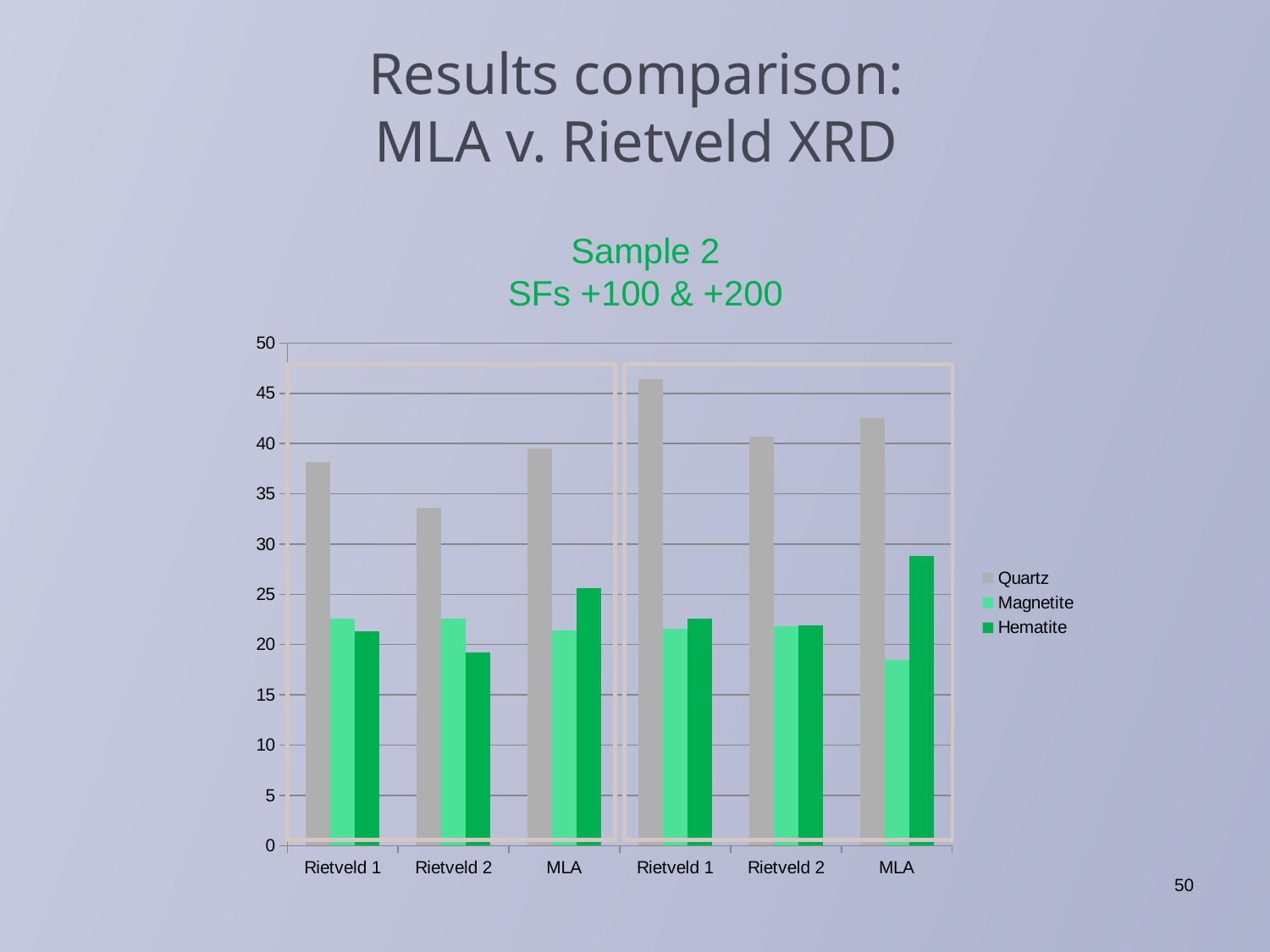
Which category group has the lowest Quartz bar? Rietveld 2 (left-hand group) How many series does the legend list? 3 Which category group has the highest Quartz bar? Rietveld 1 (right-hand group) What is the subtitle shown above the chart? Sample 2 SFs +100 & +200 Is the Quartz value for Rietveld 2 in the left-hand group greater or less than 35? less Is the Magnetite value for MLA in the right-hand group greater or less than 20? less What are the three series named in the legend? Quartz, Magnetite, Hematite Is the Hematite value for MLA in the right-hand group greater or less than 25? greater How many category groups are shown along the x axis? 6 In the left-hand MLA group, which is larger, the Hematite bar or the Magnetite bar? Hematite What kind of chart is shown on the slide? bar chart